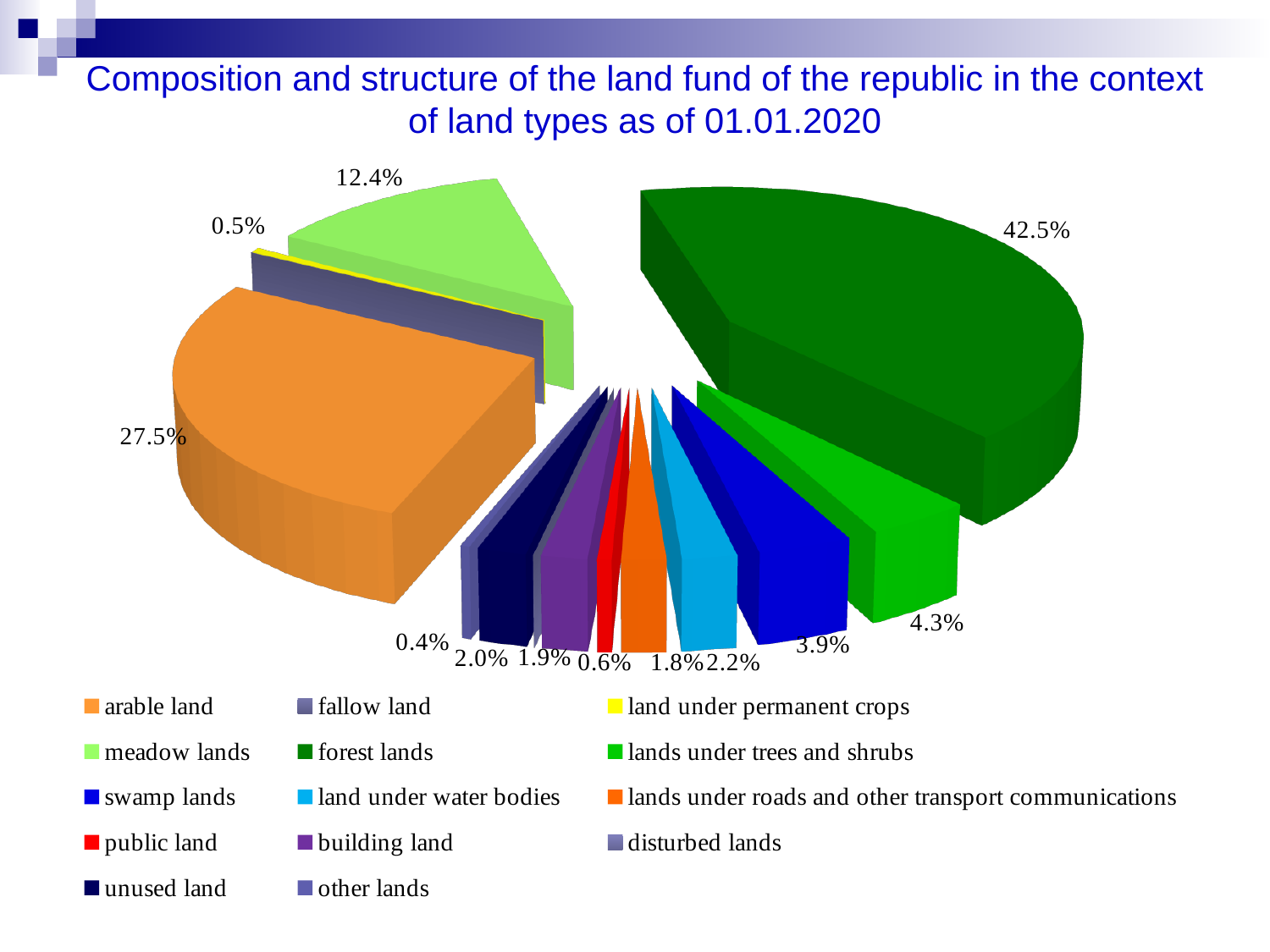
What type of chart is shown on the slide? pie chart What is the title of the chart? Composition and structure of the land fund of the republic in the context of land types as of 01.01.2020 How many land types does the legend list? 14 Which has a larger share: meadow lands or lands under trees and shrubs? meadow lands What is the difference in percentage points between the forest lands share and the arable land share? 15.0% What share of the land fund is swamp lands? 3.9% What share of the land fund is arable land? 27.5% Which land type has the largest share of the land fund? forest lands What share of the land fund is lands under trees and shrubs? 4.3% What share of the land fund is forest lands? 42.5% What share of the land fund is meadow lands? 12.4% What share of the land fund is land under water bodies? 2.2%